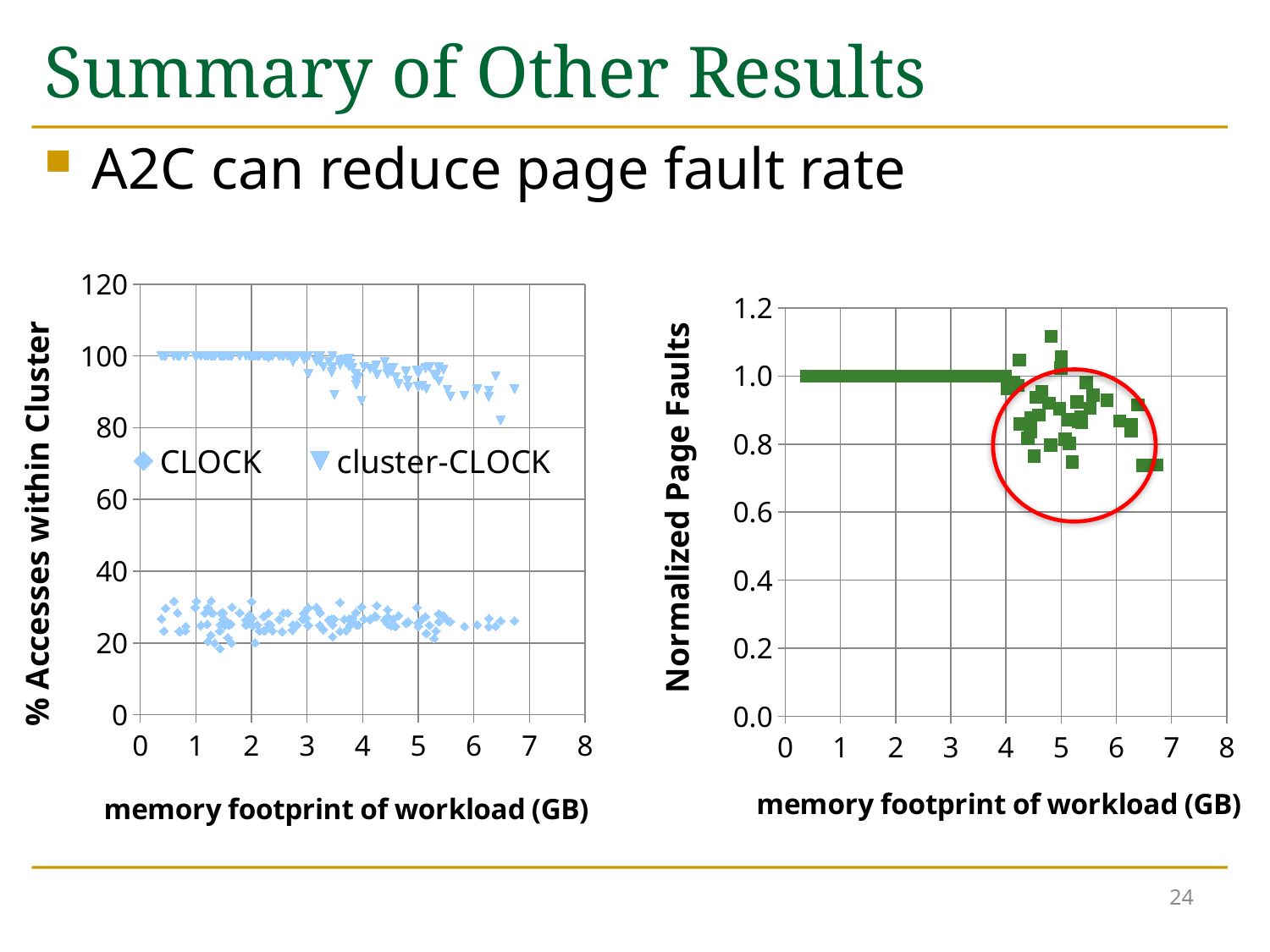
What are the two series named in the legend of the left chart? CLOCK and cluster-CLOCK What kind of chart is the right chart (Normalized Page Faults)? scatter chart In the right chart, do the Normalized Page Faults values rise or fall as the memory footprint increases beyond 4 GB? fall In the right chart, is the Normalized Page Faults value at a memory footprint of 6.5 GB greater or less than 1.0? less In the right chart, is the Normalized Page Faults value at a memory footprint of 2 GB greater or less than 0.8? greater In the left chart, is the value for cluster-CLOCK at a memory footprint of 6 GB greater or less than 80? greater How many series does the legend of the left chart list? 2 What kind of chart is the left chart (% Accesses within Cluster)? scatter chart In the left chart, which series has the higher % Accesses within Cluster, CLOCK or cluster-CLOCK? cluster-CLOCK What is the y-axis label of the right chart? Normalized Page Faults